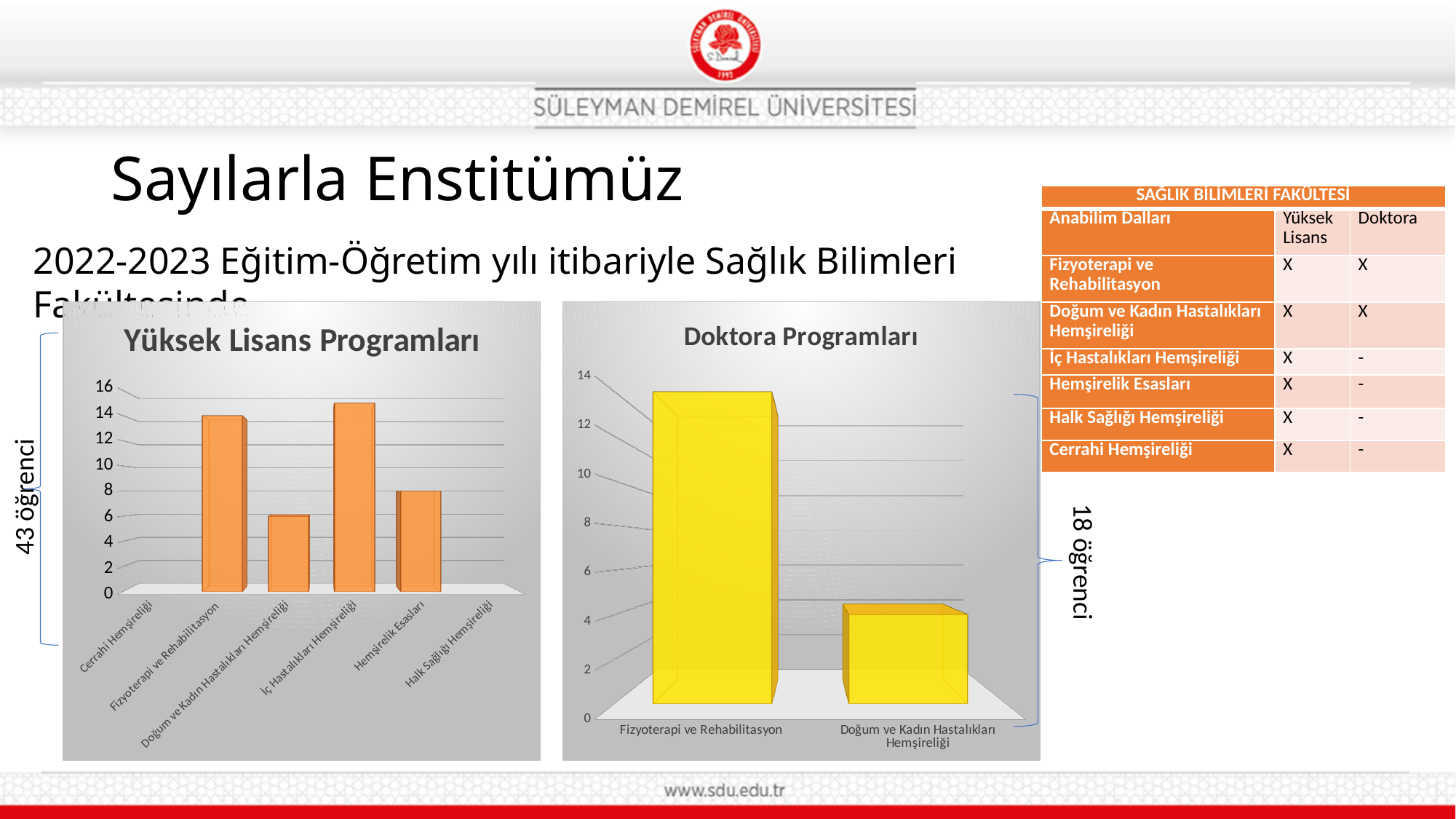
What is the title of the chart on the right side of the slide? Doktora Programları What type of chart is the "Doktora Programları" chart? bar chart In the "Yüksek Lisans Programları" chart, is the value for Fizyoterapi ve Rehabilitasyon greater or less than 10? greater How many categories are shown on the "Doktora Programları" chart? 2 In the "Doktora Programları" chart, which category has the lowest value? Doğum ve Kadın Hastalıkları Hemşireliği What type of chart is the "Yüksek Lisans Programları" chart? bar chart How many categories are labelled on the x axis of the "Yüksek Lisans Programları" chart? 6 In the "Doktora Programları" chart, which category has the highest value? Fizyoterapi ve Rehabilitasyon In the "Doktora Programları" chart, is the value for Fizyoterapi ve Rehabilitasyon greater or less than 10? greater In the "Yüksek Lisans Programları" chart, which is larger: the value for Fizyoterapi ve Rehabilitasyon or the value for Hemşirelik Esasları? Fizyoterapi ve Rehabilitasyon In the "Doktora Programları" chart, is the value for Doğum ve Kadın Hastalıkları Hemşireliği greater or less than 6? less